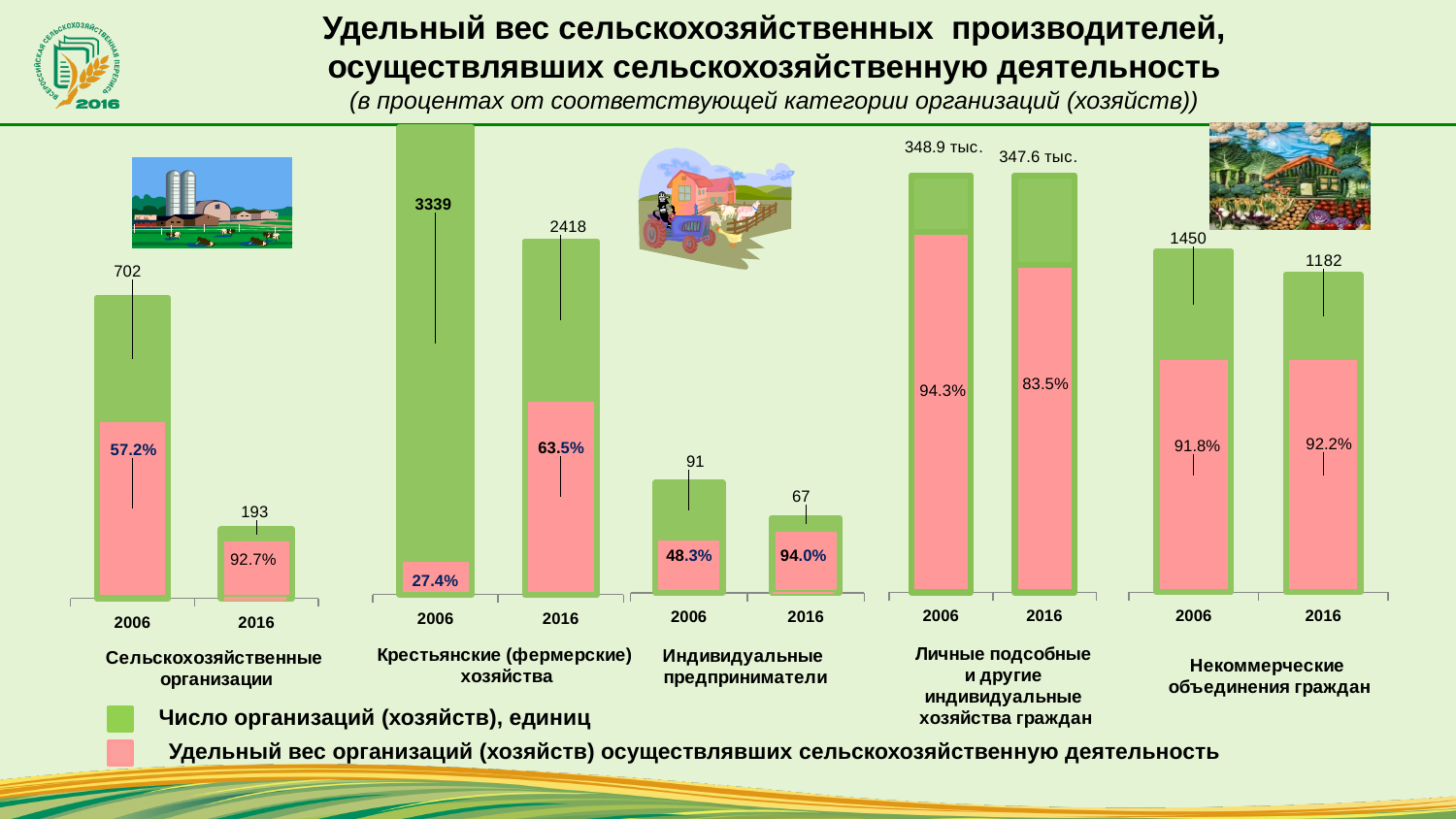
What kind of chart is used for each category on the slide? bar chart In the chart for Сельскохозяйственные организации, what is the number of organisations in 2006? 702 In the chart for Личные подсобные и другие индивидуальные хозяйства граждан, what is the number of households in 2016? 347.6 тыс. In the chart for Крестьянские (фермерские) хозяйства, by how much did the number of farms fall from 2006 to 2016? 921 In the chart for Индивидуальные предприниматели, which year has the higher number of entrepreneurs, 2006 or 2016? 2006 In the chart for Крестьянские (фермерские) хозяйства, what is the number of farms in 2006? 3339 In the chart for Некоммерческие объединения граждан, does the number of associations rise or fall from 2006 to 2016? fall In the chart for Сельскохозяйственные организации, what share of organisations carried out agricultural activity in 2016? 92.7% In the chart for Индивидуальные предприниматели, what is the share carrying out agricultural activity in 2016? 94.0% In the chart for Некоммерческие объединения граждан, what is the number of associations in 2006? 1450 In the chart for Крестьянские (фермерские) хозяйства, what is the share of farms carrying out agricultural activity in 2006? 27.4% How many series does the legend at the bottom of the slide list? 2